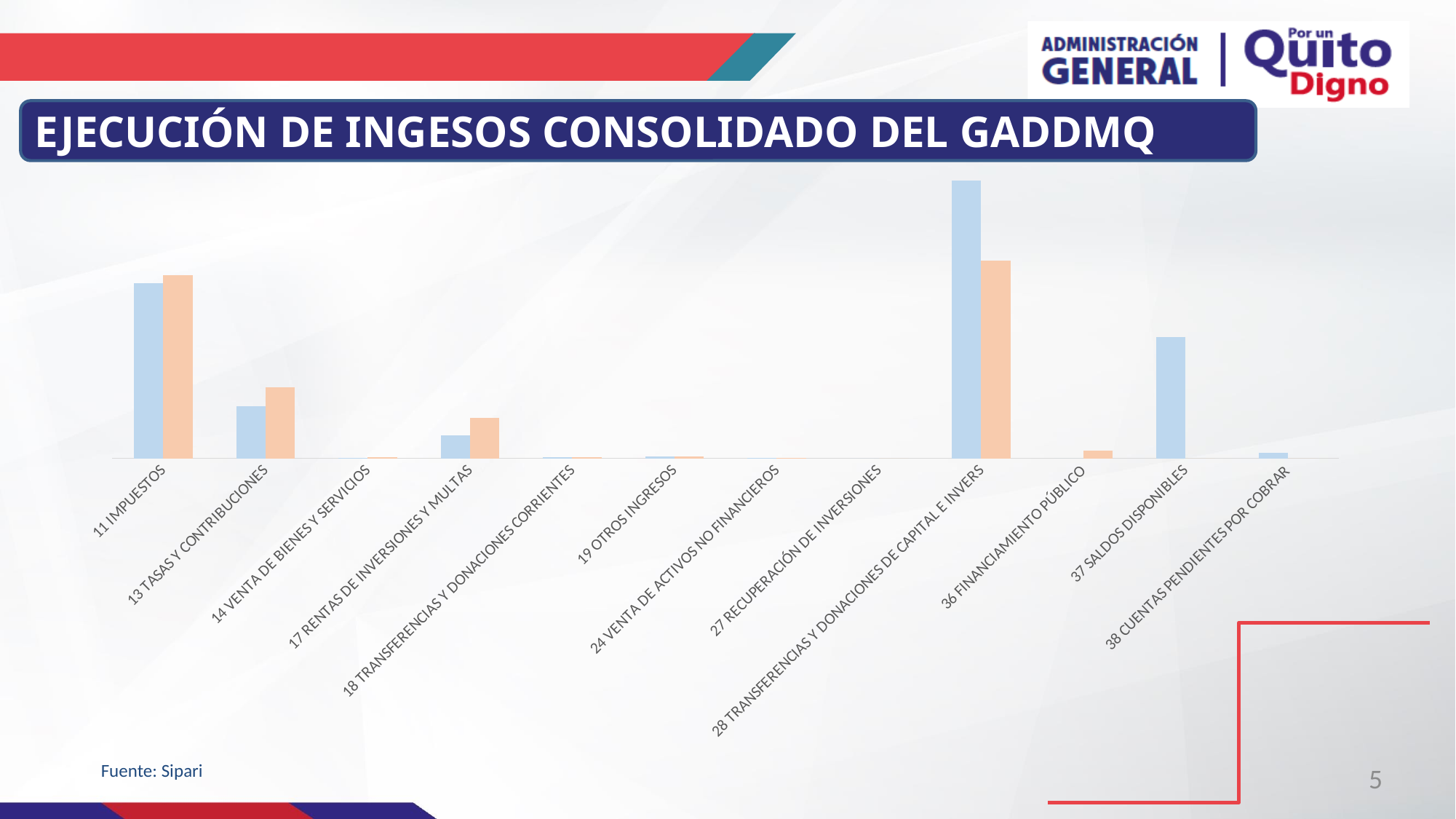
Which category has the tallest bar in the chart? 28 TRANSFERENCIAS Y DONACIONES DE CAPITAL E INVERS Which category has the taller blue bar, 13 TASAS Y CONTRIBUCIONES or 17 RENTAS DE INVERSIONES Y MULTAS? 13 TASAS Y CONTRIBUCIONES What is the title of the chart on the slide? EJECUCIÓN DE INGESOS CONSOLIDADO DEL GADDMQ What kind of chart is shown on the slide? bar chart For the category 13 TASAS Y CONTRIBUCIONES, which bar is taller, the blue one or the orange one? the orange one For the category 28 TRANSFERENCIAS Y DONACIONES DE CAPITAL E INVERS, which bar is taller, the blue one or the orange one? the blue one How many categories are shown along the x axis of the chart? 12 What source is cited for the chart data? Sipari